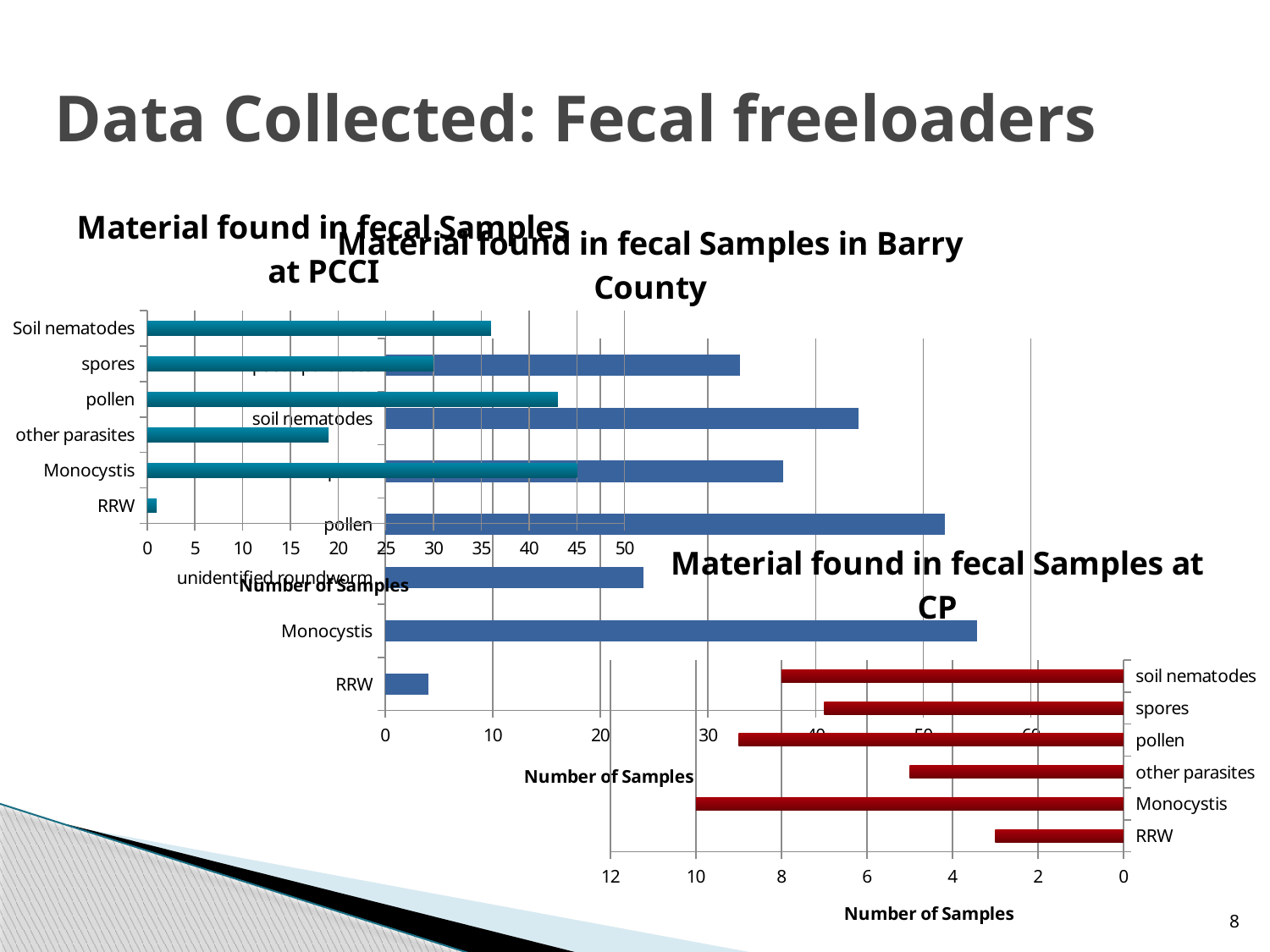
What is the x-axis title of the 'Material found in fecal Samples at CP' chart? Number of Samples In the 'Material found in fecal Samples at PCCI' chart, which category has the lowest number of samples? RRW In the 'Material found in fecal Samples at CP' chart, what is the number of samples for Monocystis? 10 In the 'Material found in fecal Samples at CP' chart, which category has the lowest number of samples? RRW What kind of chart is 'Material found in fecal Samples at PCCI'? bar chart In the 'Material found in fecal Samples in Barry County' chart, is the value for unidentified roundworm greater or less than 20? greater In the 'Material found in fecal Samples at PCCI' chart, how many categories are shown? 6 In the 'Material found in fecal Samples at PCCI' chart, is the value for pollen greater or less than 40? greater In the 'Material found in fecal Samples at CP' chart, is the value for other parasites greater or less than 6? less In the 'Material found in fecal Samples at PCCI' chart, which is larger, pollen or other parasites? pollen In the 'Material found in fecal Samples in Barry County' chart, which category has the lowest number of samples? RRW In the 'Material found in fecal Samples in Barry County' chart, which category has the highest number of samples? Monocystis